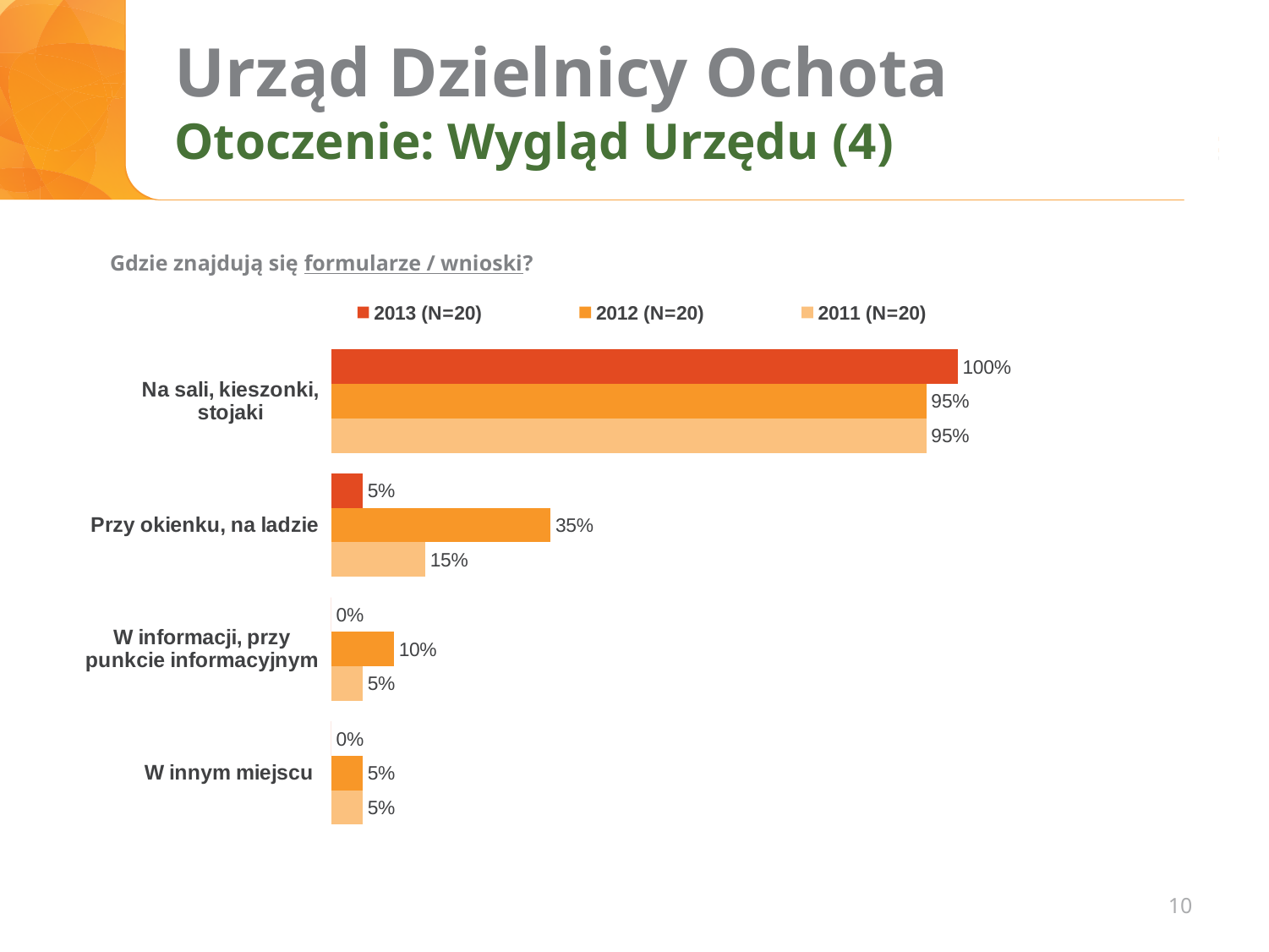
Which category has the highest value in the 2012 (N=20) series? Na sali, kieszonki, stojaki What is the value for "Przy okienku, na ladzie" in the 2012 (N=20) series? 35% What is the value for "W innym miejscu" in the 2013 (N=20) series? 0% What is the value for "Na sali, kieszonki, stojaki" in the 2013 (N=20) series? 100% For "Przy okienku, na ladzie", which series has the larger value: 2013 (N=20) or 2012 (N=20)? 2012 (N=20) What is the value for "W informacji, przy punkcie informacyjnym" in the 2011 (N=20) series? 5% What is the difference between the 2012 (N=20) and 2011 (N=20) values for "Przy okienku, na ladzie"? 20% Which category has the lowest value in the 2011 (N=20) series? W informacji, przy punkcie informacyjnym and W innym miejscu (both 5%) How many categories are shown on the chart? 4 What question does the chart answer, as stated above it? Gdzie znajdują się formularze / wnioski? How many series does the legend list? 3 What kind of chart is shown on the slide? Bar chart